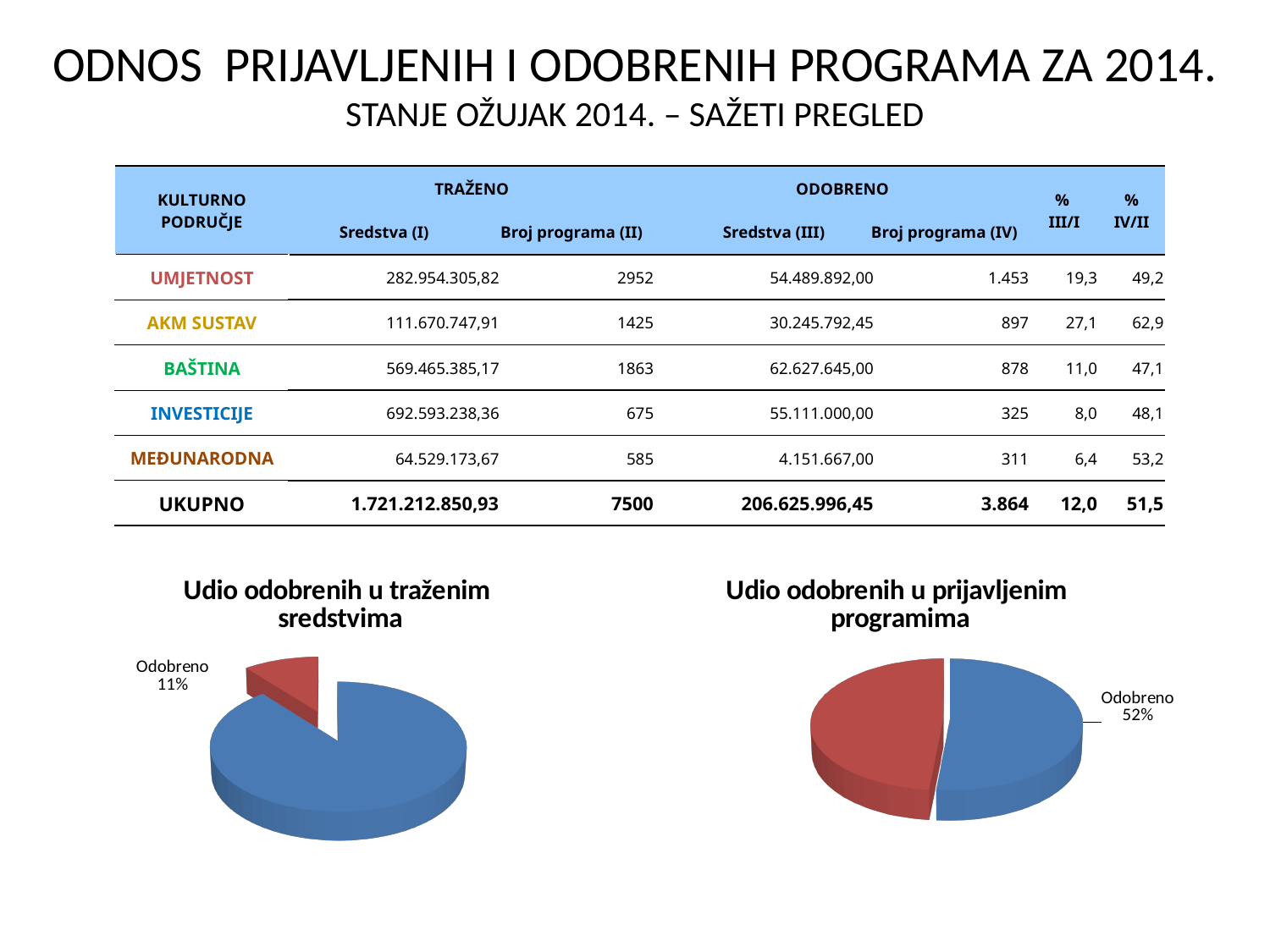
What colour is the Odobreno slice in the chart "Udio odobrenih u traženim sredstvima"? red What is the title of the pie chart on the left of the slide? Udio odobrenih u traženim sredstvima What kind of chart is the chart titled "Udio odobrenih u prijavljenim programima"? pie chart What is the difference between the Odobreno share in the right pie chart (52%) and the Odobreno share in the left pie chart (11%)? 41% How many slices does the pie chart "Udio odobrenih u prijavljenim programima" have? 2 In the chart "Udio odobrenih u traženim sredstvima", what share of the pie is labelled Odobreno? 11% In the chart "Udio odobrenih u traženim sredstvima", which slice is the smallest? Odobreno What kind of chart is the chart titled "Udio odobrenih u traženim sredstvima"? pie chart In the chart "Udio odobrenih u prijavljenim programima", which slice is the largest? Odobreno Which chart shows a larger Odobreno share, "Udio odobrenih u traženim sredstvima" or "Udio odobrenih u prijavljenim programima"? Udio odobrenih u prijavljenim programima How many slices does the pie chart "Udio odobrenih u traženim sredstvima" have? 2 In the chart "Udio odobrenih u prijavljenim programima", what share of the pie is labelled Odobreno? 52%